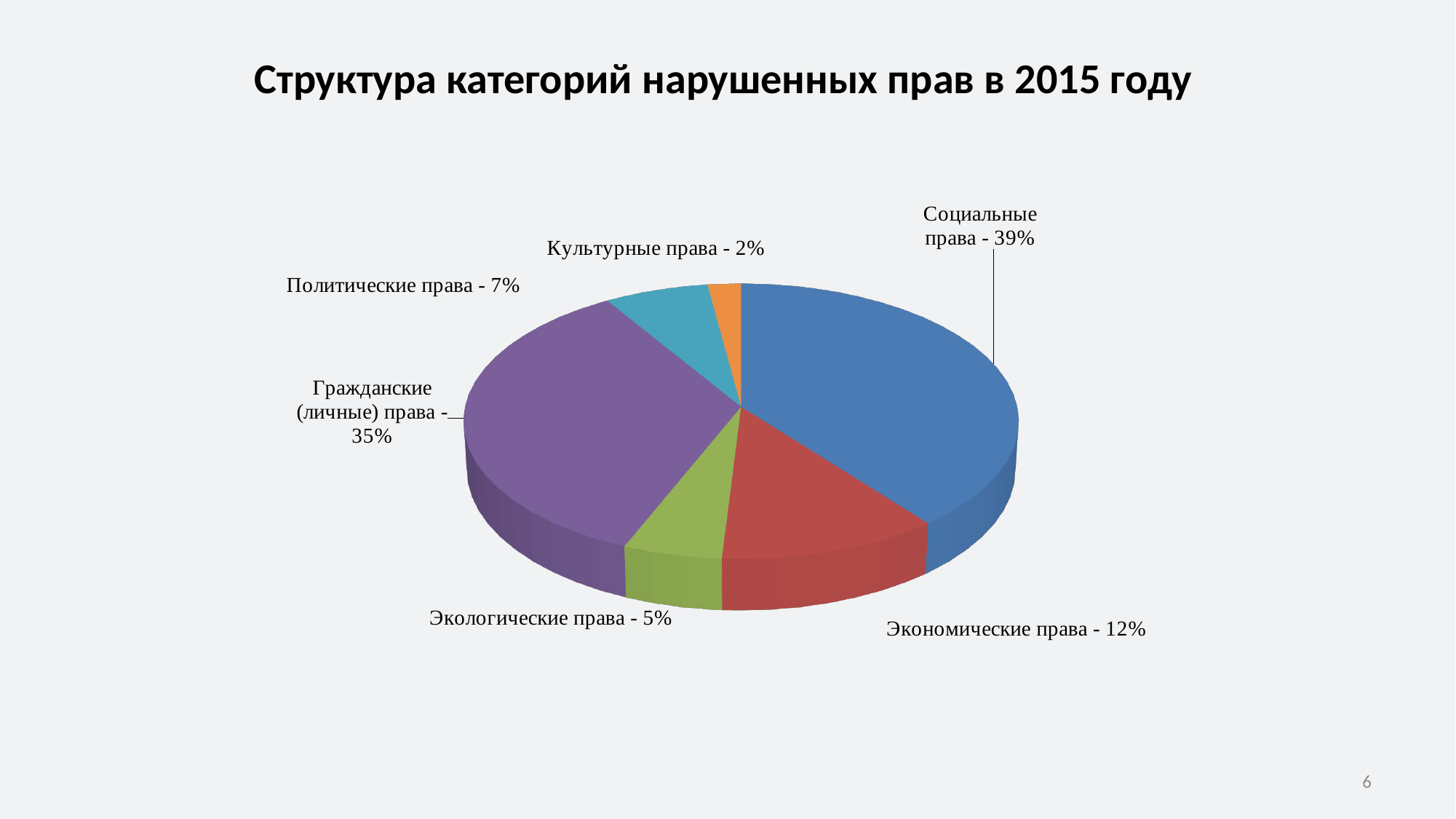
What share of the pie is Культурные права? 2% What share of the pie is Экономические права? 12% Which category has the largest share of the pie? Социальные права What is the difference in percentage points between Социальные права and Гражданские (личные) права? 4 What is the title of the chart? Структура категорий нарушенных прав в 2015 году What kind of chart is shown on the slide? Pie chart How many categories are shown in the pie chart? 6 What share of the pie is Социальные права? 39% Which is larger, Политические права or Экологические права? Политические права What is the difference in percentage points between Экономические права and Экологические права? 7 Which category has the smallest share of the pie? Культурные права